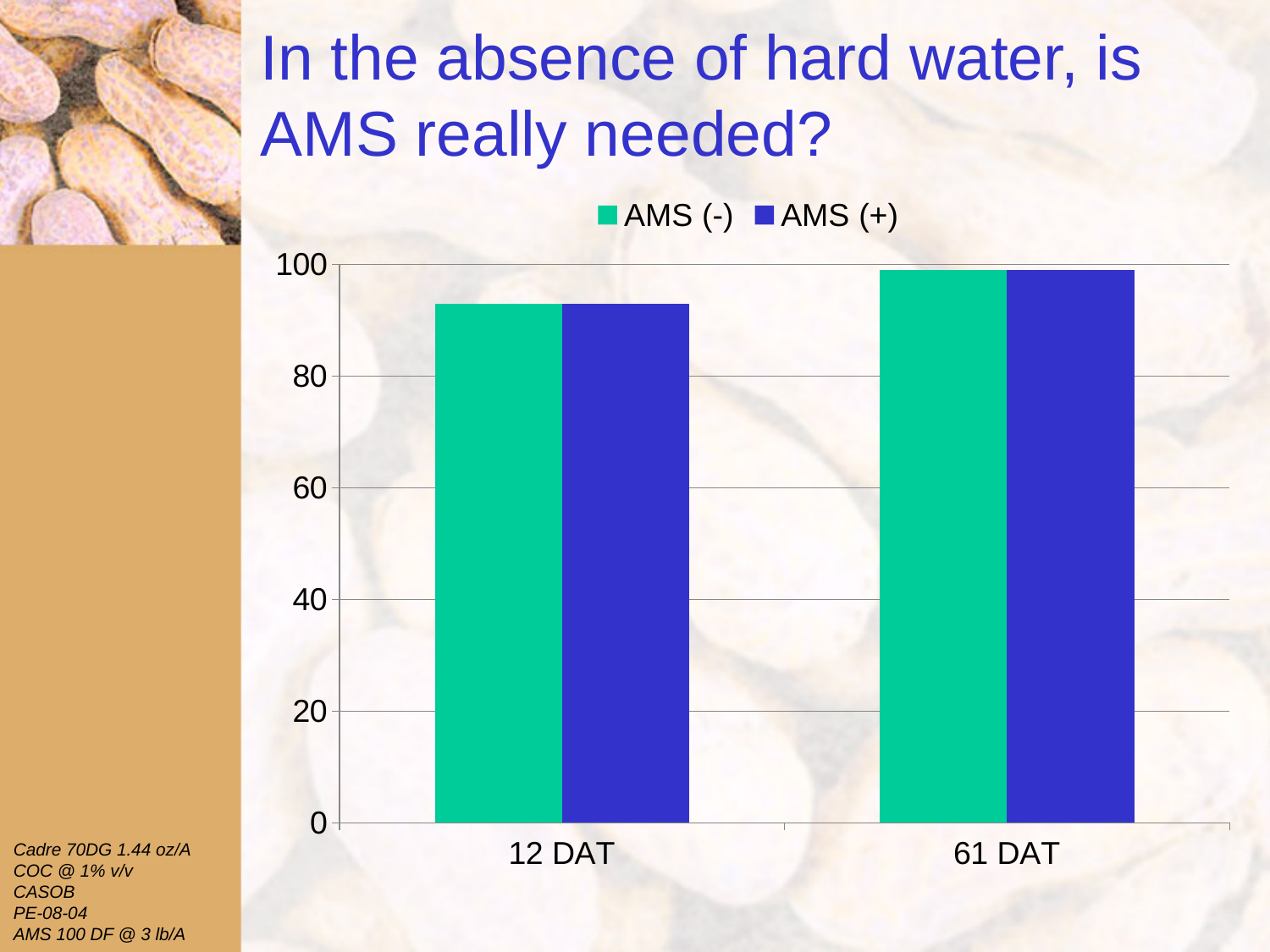
How many series does the legend list? 2 How many categories are shown on the x axis? 2 Which colour represents the AMS (+) series? blue For the AMS (+) series, which category has the lower value? 12 DAT What kind of chart is shown on the slide? bar chart Is the value for AMS (-) at 61 DAT greater or less than 80? greater Is the value for AMS (-) at 12 DAT greater or less than 80? greater Is the value for AMS (+) at 12 DAT greater or less than 100? less Do the values rise or fall from 12 DAT to 61 DAT? rise For the AMS (-) series, which category has the higher value, 12 DAT or 61 DAT? 61 DAT What are the two series named in the legend? AMS (-) and AMS (+)